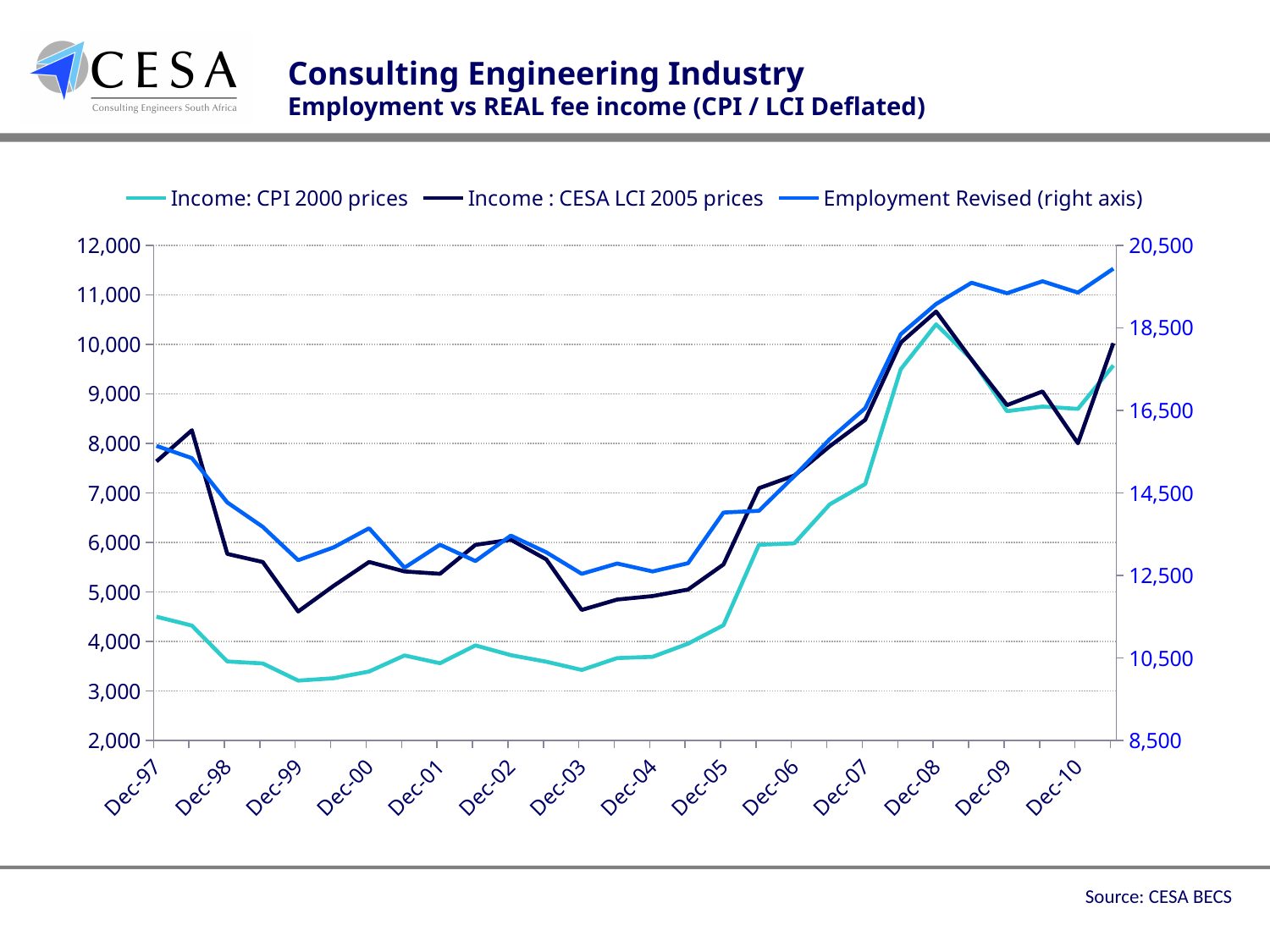
Does the Income: CPI 2000 prices series rise or fall between Dec-05 and Dec-08? Rise Is the value for Income: CPI 2000 prices at Dec-97 greater or less than 4,000? greater At which x-axis label does the Income : CESA LCI 2005 prices series reach its highest value? Dec-08 Which series is plotted against the right axis? Employment Revised (right axis) What kind of chart is shown on the slide? Line chart Is the value for Income : CESA LCI 2005 prices at Dec-99 greater or less than 5,000? less How many series does the legend list? 3 How many year labels (Dec-97 to Dec-10) are shown on the x axis? 14 What is the subtitle of the chart on the slide? Employment vs REAL fee income (CPI / LCI Deflated) Is the value for Employment Revised at Dec-08 greater or less than 18,500? greater At which x-axis label does the Income: CPI 2000 prices series reach its highest value? Dec-08